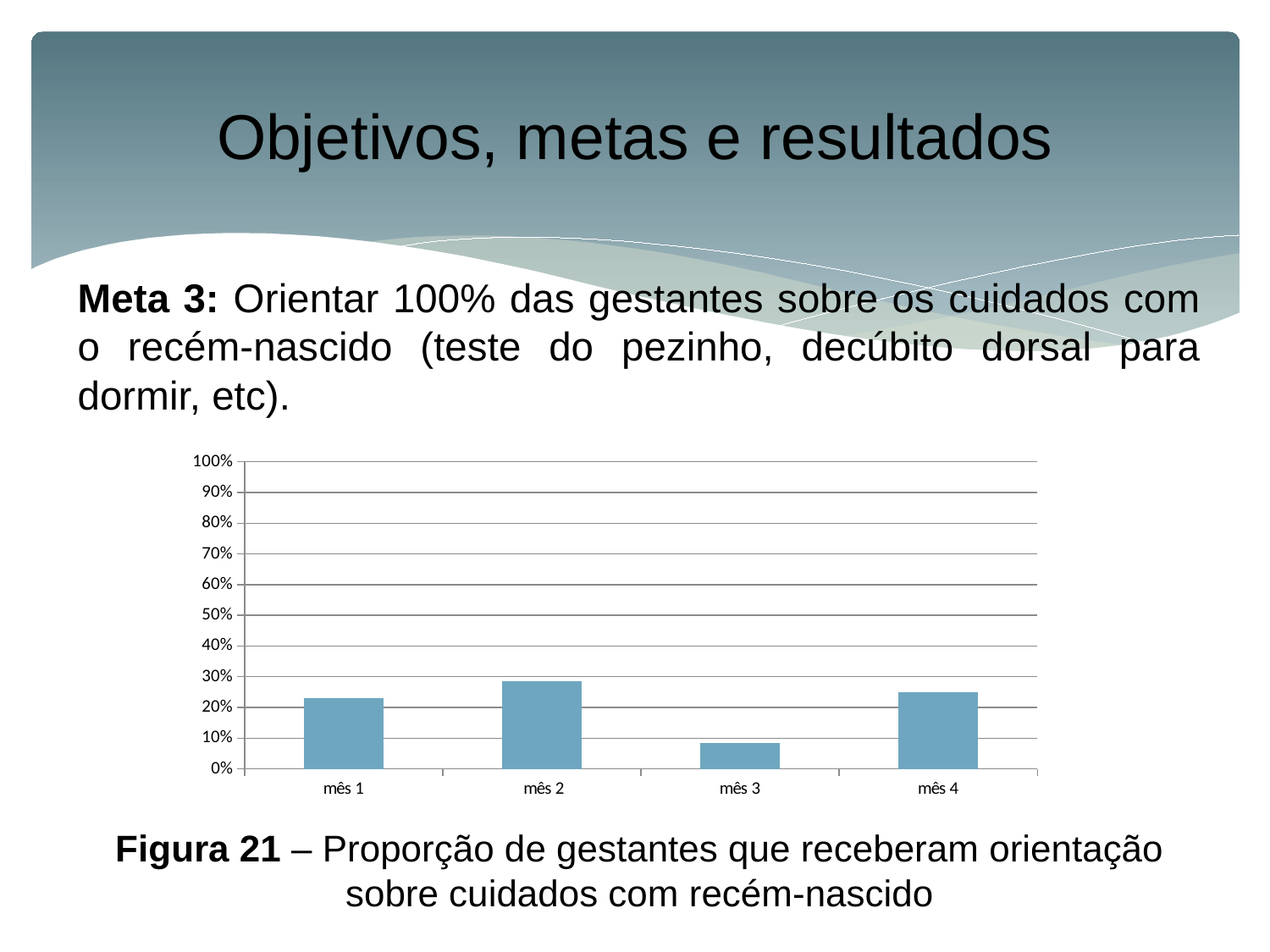
Is the value for mês 1 greater or less than 20%? greater Is the value for mês 4 greater or less than 30%? less What kind of chart is shown on the slide? bar chart Is the value for mês 2 greater or less than 20%? greater What is the highest value shown on the y axis of the chart? 100% Which month has the lowest proportion in the chart? mês 3 Which month has the highest proportion in the chart? mês 2 How many months (categories) are shown on the x axis of the chart? 4 Which is larger, the value for mês 2 or the value for mês 3? mês 2 What figure number is given in the caption below the chart? Figura 21 Which is larger, the value for mês 1 or the value for mês 3? mês 1